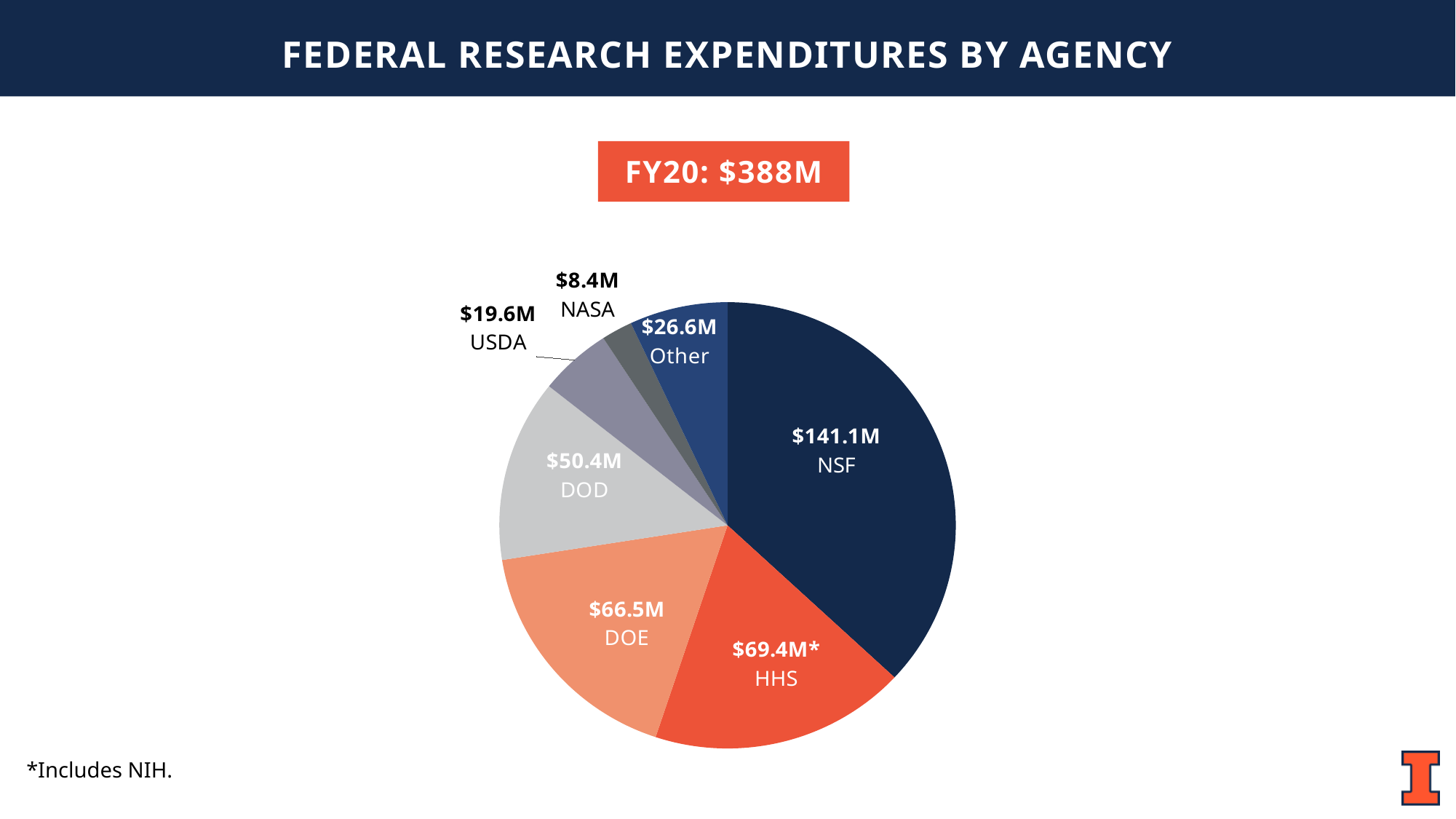
Which agency has the largest share of federal research expenditures? NSF Which is larger, the expenditure for HHS or for DOE? HHS According to the footnote, what does the asterisk on the HHS value indicate? Includes NIH Which agency has the smallest slice of the pie? NASA How much larger is the NSF expenditure than the HHS expenditure? $71.7M What is the federal research expenditure for NSF? $141.1M What is the federal research expenditure for DOD? $50.4M How many slices does the pie chart have? 7 What is the federal research expenditure for USDA? $19.6M What kind of chart is shown on the slide? pie chart What total federal research expenditure is shown for FY20? $388M What is the difference between the DOE and DOD expenditures? $16.1M